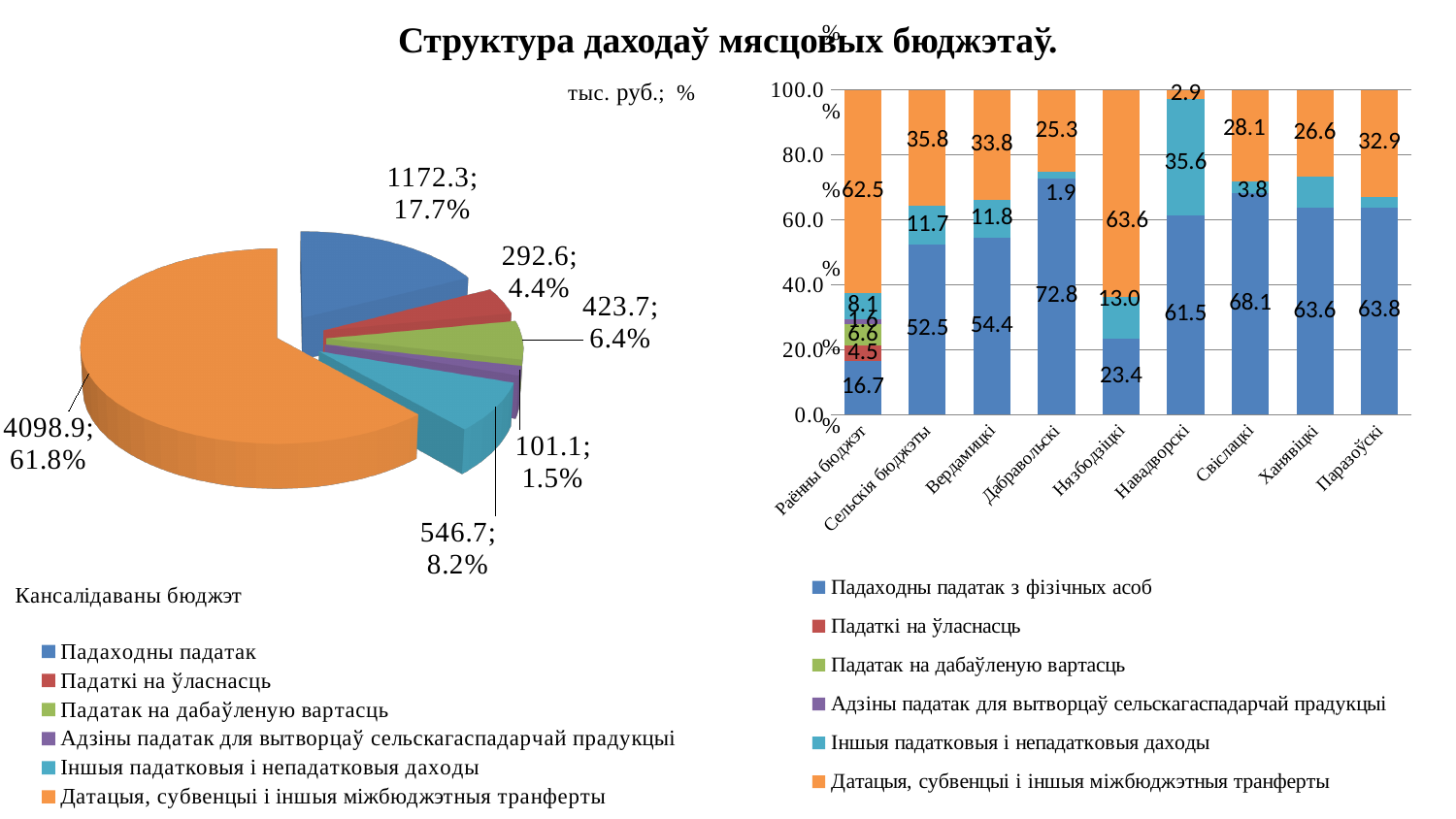
On the bar chart on the right, what is the value of Датацыі, субвенцыі і іншыя міжбюджэтныя трансферты for Нязбодзіцкі? 63.6 On the pie chart (Кансалідаваны бюджэт), how many slices are there? 6 On the bar chart on the right, what is the value of Падаходны падатак з фізічных асоб for Дабравольскі? 72.8 On the pie chart (Кансалідаваны бюджэт), what share does Падаходны падатак have? 17.7% On the bar chart on the right, which category has the highest value for Падаходны падатак з фізічных асоб? Дабравольскі On the bar chart on the right, how many budget categories are shown on the x axis? 9 What kind of chart is the chart on the right side of the slide? Stacked bar chart On the pie chart (Кансалідаваны бюджэт), what value is shown for Датацыі, субвенцыі і іншыя міжбюджэтныя трансферты? 4098.9; 61.8% On the bar chart on the right, how many series does the legend list? 6 On the pie chart (Кансалідаваны бюджэт), which slice is the largest? Датацыі, субвенцыі і іншыя міжбюджэтныя трансферты On the bar chart on the right, what is the difference between the Падаходны падатак з фізічных асоб values for Дабравольскі and Свіслацкі? 4.7 On the pie chart (Кансалідаваны бюджэт), which slice is the smallest? Адзіны падатак для вытворцаў сельскагаспадарчай прадукцыі